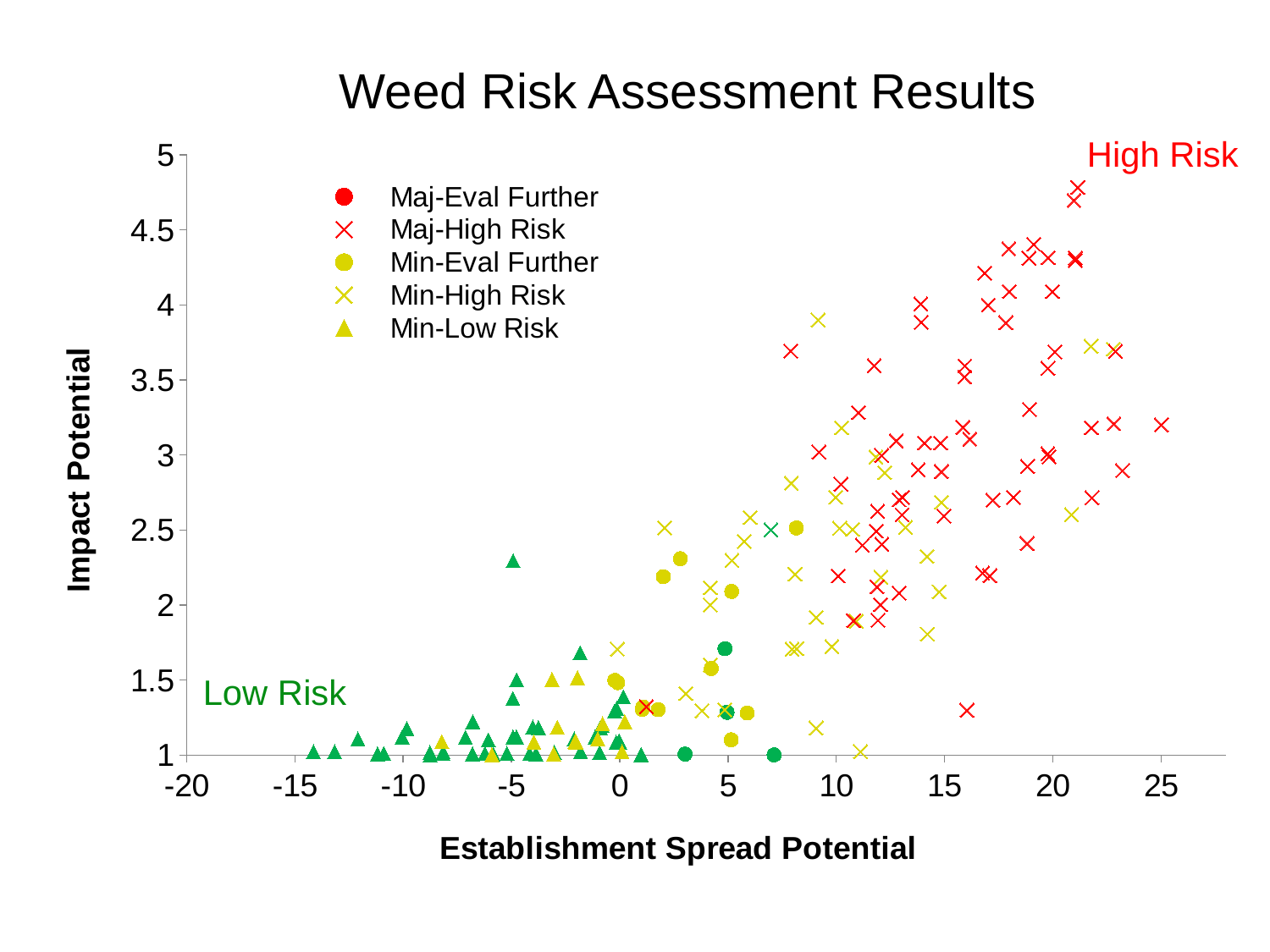
What kind of chart is shown on the slide? scatter chart How many series does the legend list? 5 Is the Establishment Spread Potential of the rightmost Maj-High Risk point greater or less than 20? greater Which series has the point with the highest Impact Potential? Maj-High Risk Is the Impact Potential of the highest Min-Low Risk point greater or less than 2.5? less Which series reaches a higher Impact Potential, Maj-High Risk or Min-Low Risk? Maj-High Risk What is the label of the x axis? Establishment Spread Potential Is the Impact Potential of the highest Maj-High Risk point greater or less than 4.5? greater What is the title of the chart? Weed Risk Assessment Results Do Impact Potential values generally rise or fall as Establishment Spread Potential increases? rise Which series has the point with the lowest Establishment Spread Potential? Min-Low Risk